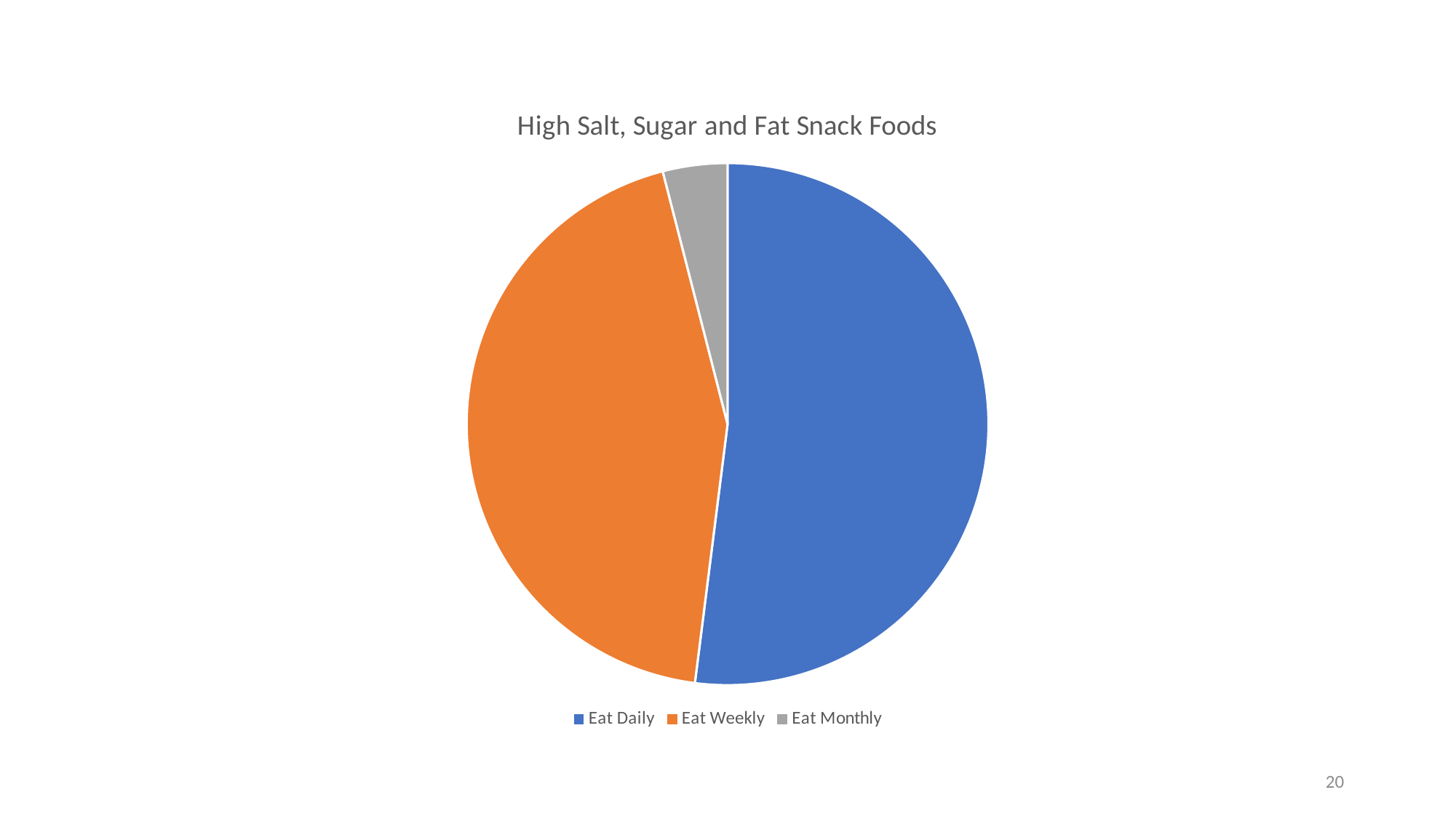
Which slice is larger, Eat Daily or Eat Weekly? Eat Daily Which category has the largest slice of the pie? Eat Daily How many entries does the legend list? 3 How many slices does the pie chart have? 3 Which slice is larger, Eat Weekly or Eat Monthly? Eat Weekly What colour is the Eat Weekly slice? orange What kind of chart is shown on the slide? pie chart What is the title of the chart? High Salt, Sugar and Fat Snack Foods Which category has the smallest slice of the pie? Eat Monthly